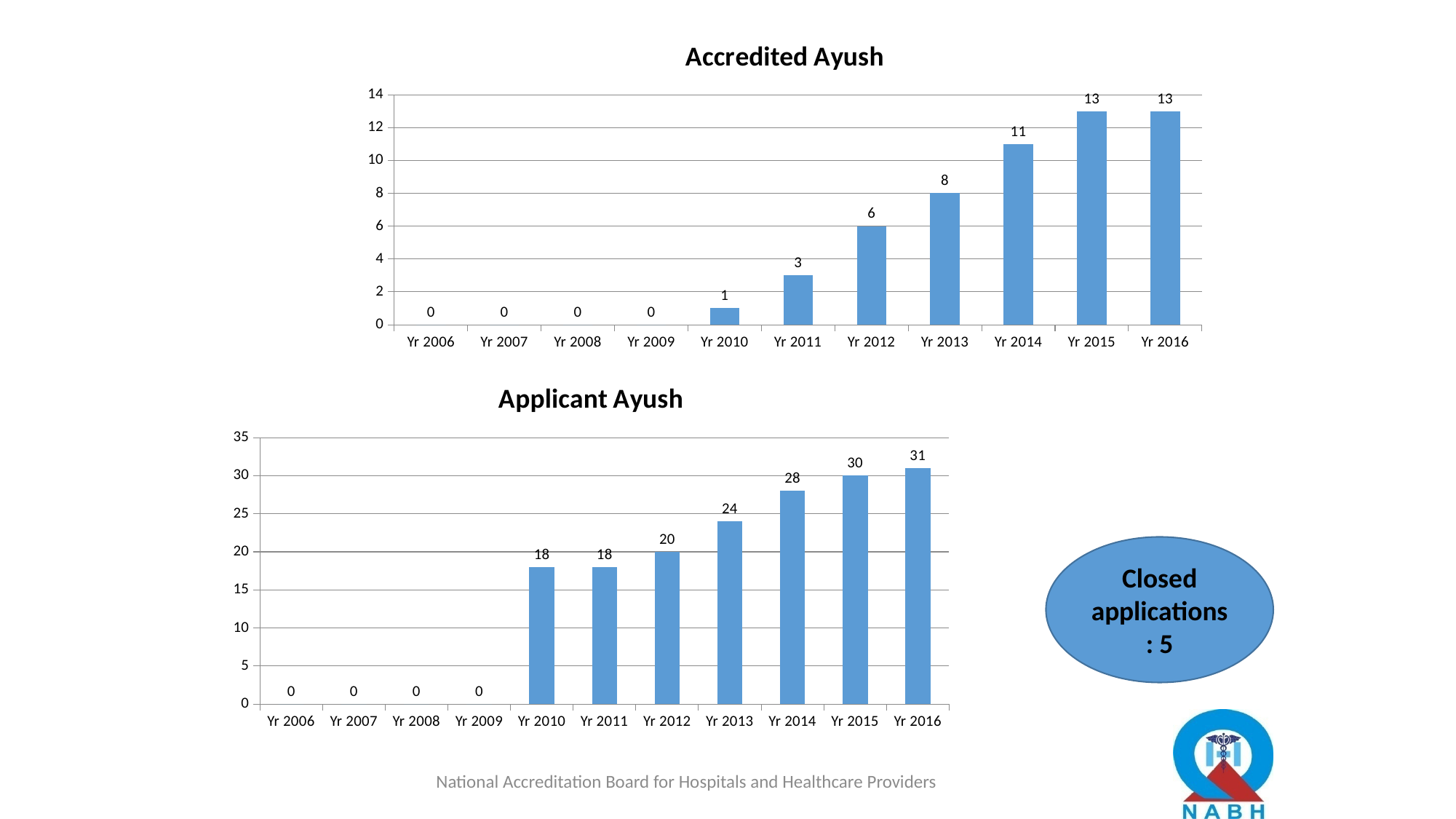
In the 'Applicant Ayush' chart, what is the value for Yr 2013? 24 In the 'Accredited Ayush' chart, what is the difference between the values for Yr 2013 and Yr 2012? 2 In the 'Accredited Ayush' chart, what is the value for Yr 2010? 1 How many years are shown on the x axis of the 'Accredited Ayush' chart? 11 In the 'Accredited Ayush' chart, do the values generally rise or fall from Yr 2010 to Yr 2016? rise What kind of chart is the 'Applicant Ayush' chart? bar chart In the 'Applicant Ayush' chart, what is the difference between the values for Yr 2016 and Yr 2010? 13 In the 'Accredited Ayush' chart, which is larger, the value for Yr 2011 or the value for Yr 2012? Yr 2012 In the 'Applicant Ayush' chart, which year has the highest value? Yr 2016 In the 'Applicant Ayush' chart, is the value for Yr 2014 greater or less than 25? greater In the 'Accredited Ayush' chart, what is the value for Yr 2014? 11 What is the title of the top chart on the slide? Accredited Ayush